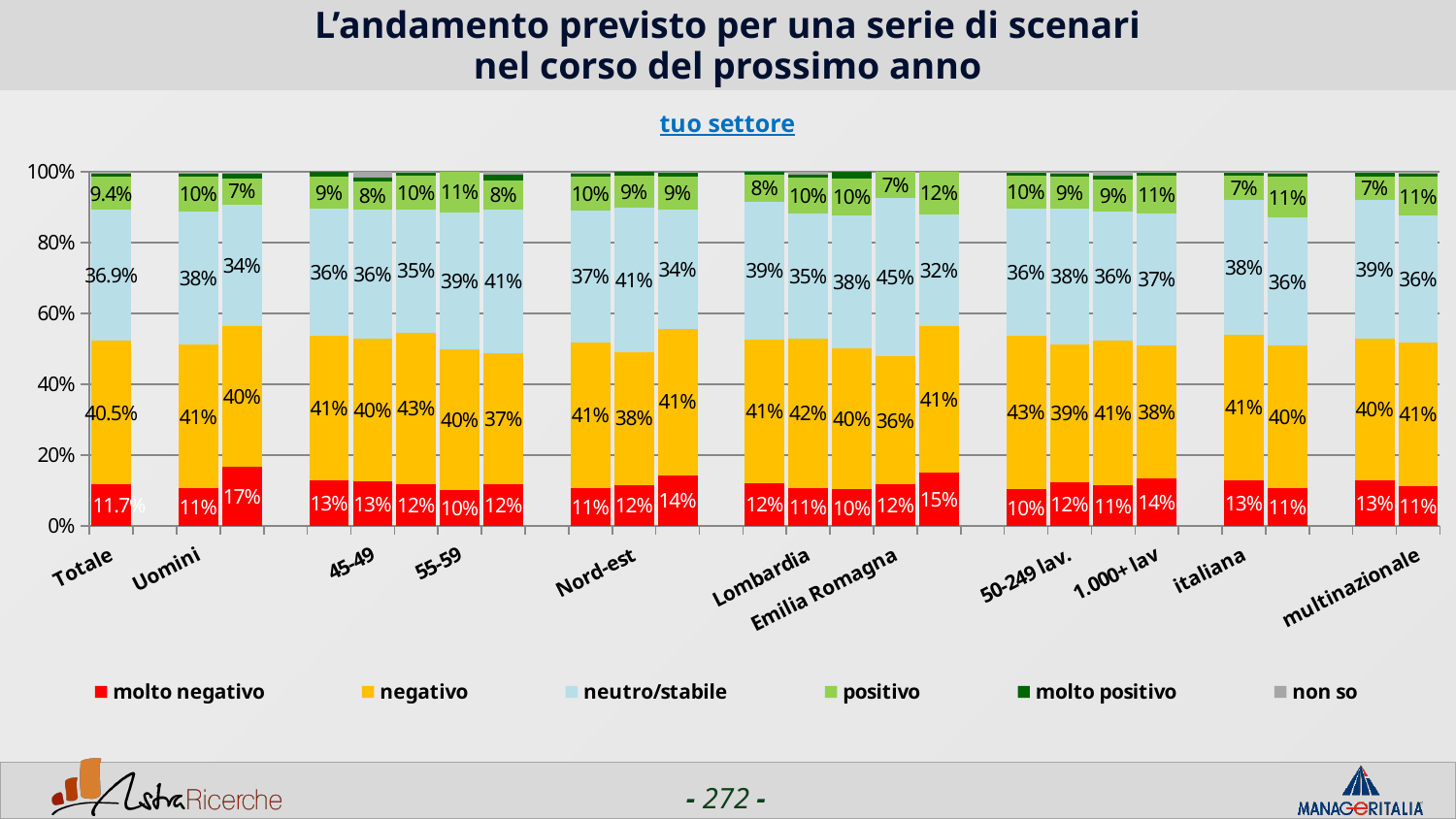
What is the 'neutro/stabile' value for Emilia Romagna? 45% What is the 'negativo' value for Totale? 40.5% What type of chart is shown on the slide? stacked bar chart What is the 'positivo' value for italiana? 7% What is the 'molto negativo' value for 1.000+ lav? 14% How many series does the legend list? 6 Which is larger for Lombardia: the 'negativo' value or the 'neutro/stabile' value? negativo Which legend entry is shown in red? molto negativo What is the 'positivo' value for multinazionale? 11% What is the 'neutro/stabile' value for Uomini? 38% What is the 'molto negativo' value for Totale? 11.7% What is the difference between the 'neutro/stabile' values for Emilia Romagna and Lombardia? 10%